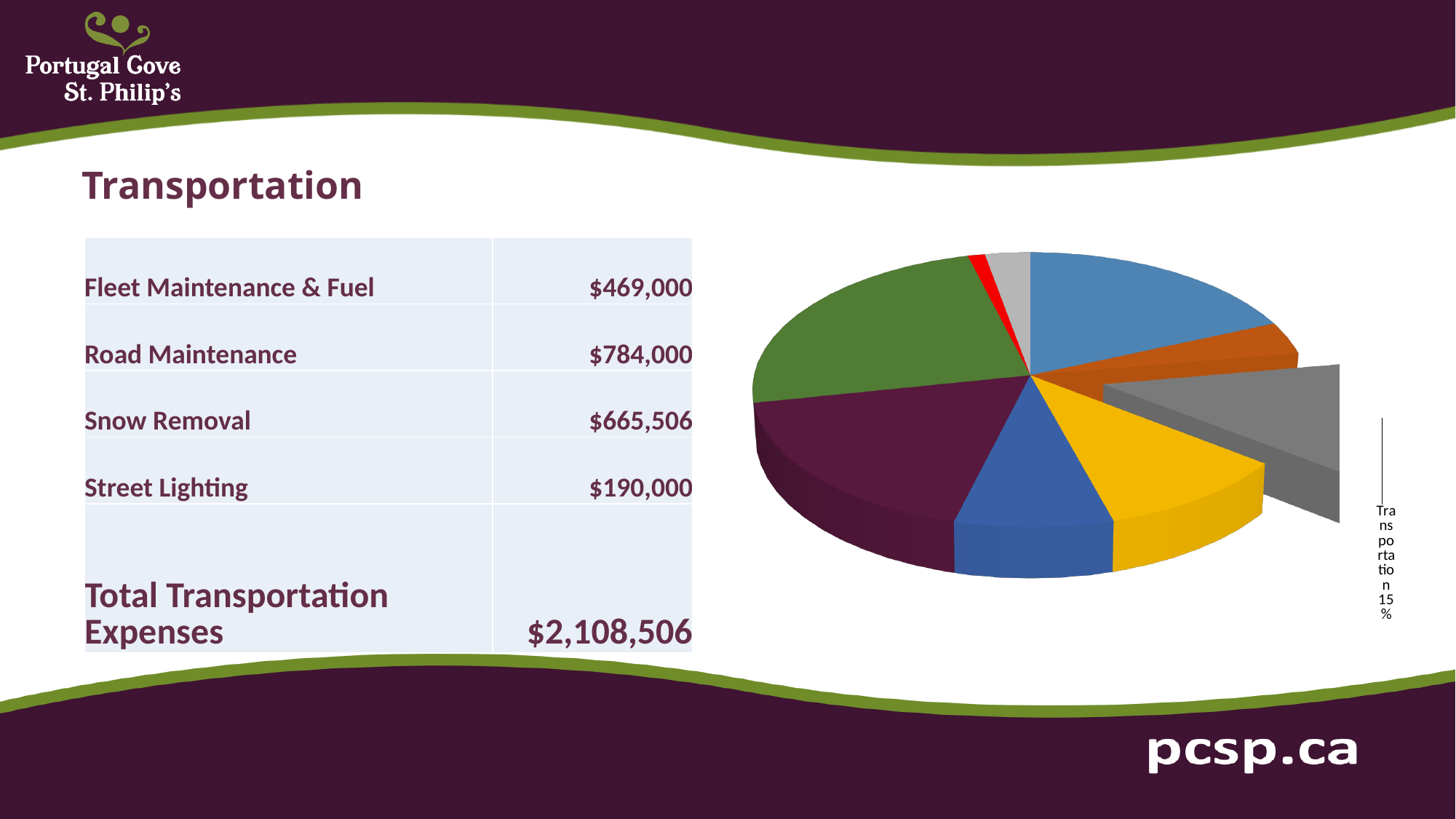
Which slice of the pie chart has a data label showing its percentage? Transportation In the pie chart, which is larger: the Transportation slice or the red slice? Transportation How many slices does the pie chart have? 9 In the pie chart, which is larger: the purple slice or the red slice? the purple slice What colour is the Transportation slice in the pie chart? gray Which slice of the pie chart is pulled out (exploded) from the rest of the pie? Transportation What share of the pie chart is labelled for the Transportation slice? 15% What kind of chart is shown on the right of the slide? pie chart